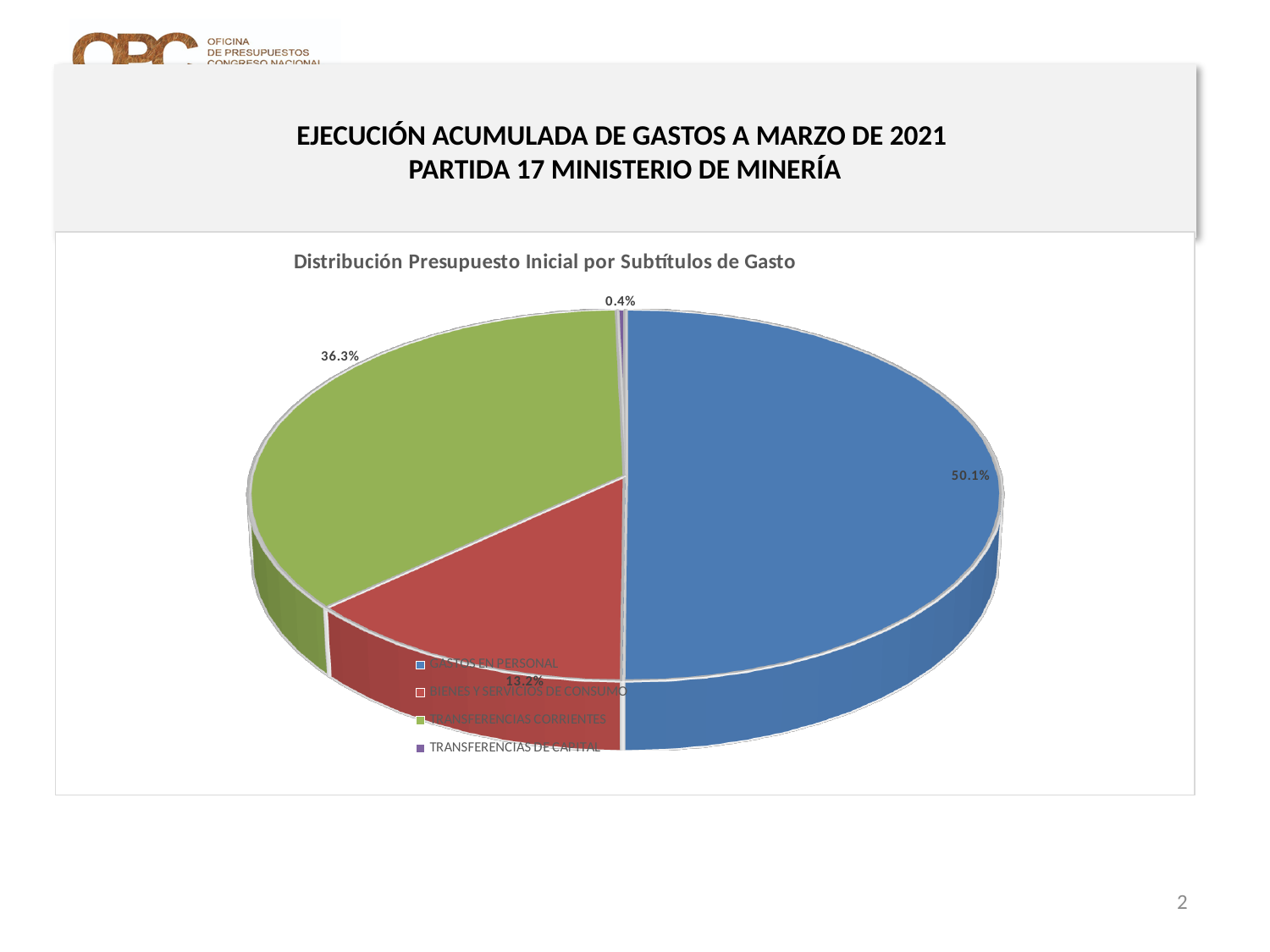
How many categories does the pie chart show? 4 Which category has the largest slice of the pie? GASTOS EN PERSONAL What kind of chart is shown on the slide? Pie chart What share of the pie does BIENES Y SERVICIOS DE CONSUMO represent? 13.2% What share of the pie does GASTOS EN PERSONAL represent? 50.1% Which is larger, the share for BIENES Y SERVICIOS DE CONSUMO or the share for TRANSFERENCIAS CORRIENTES? TRANSFERENCIAS CORRIENTES What share of the pie does TRANSFERENCIAS CORRIENTES represent? 36.3% What is the difference in percentage points between GASTOS EN PERSONAL and TRANSFERENCIAS CORRIENTES? 13.8 What colour is the slice for GASTOS EN PERSONAL? Blue Which category has the smallest slice of the pie? TRANSFERENCIAS DE CAPITAL What is the title of the chart? Distribución Presupuesto Inicial por Subtítulos de Gasto